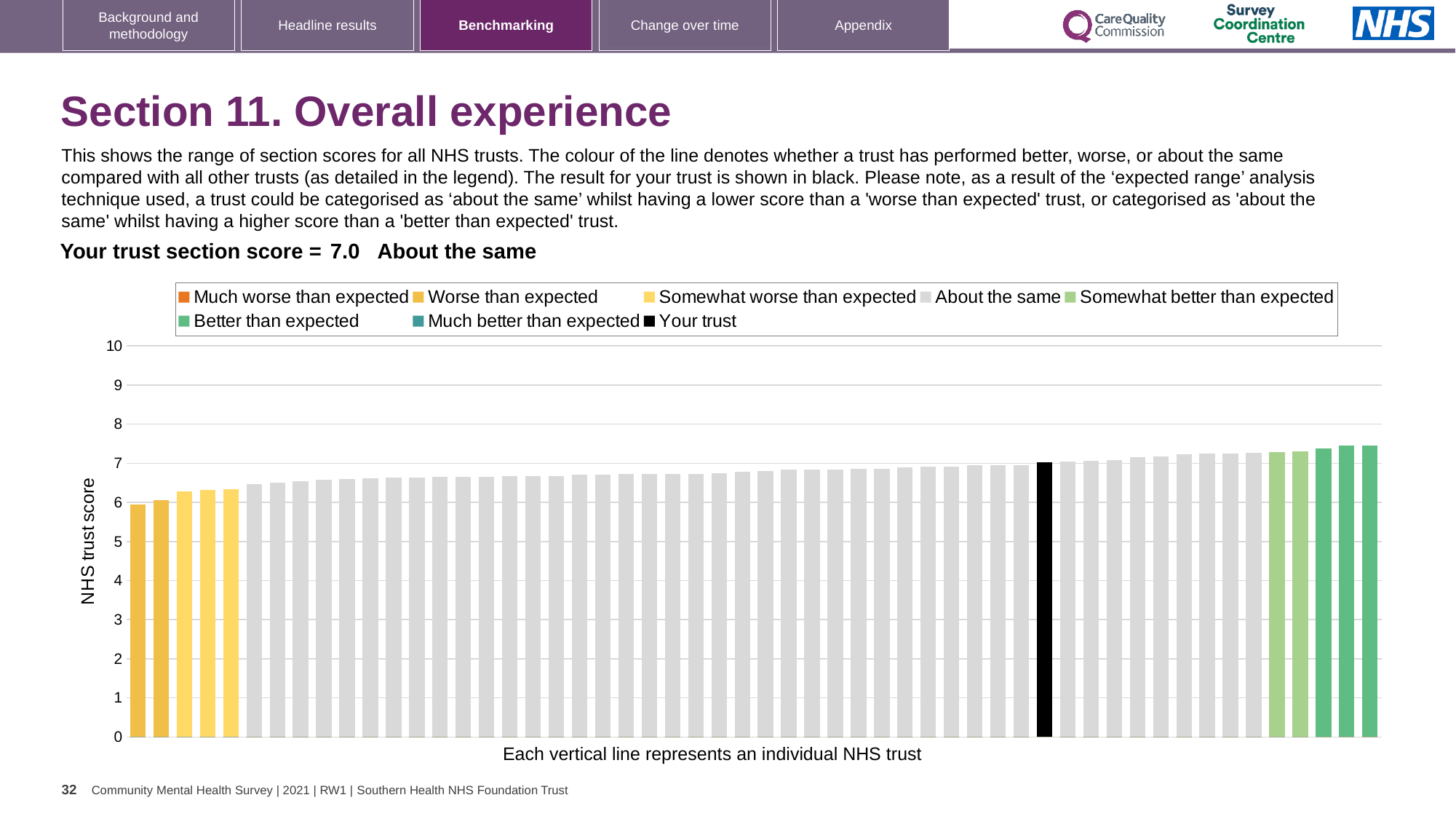
What kind of chart is shown on the slide? Bar chart How many entries does the chart legend list? 8 Is the value of the black 'Your trust' bar greater or less than 6? greater Is the value of the tallest bar on the chart greater or less than 7? greater What colour is used for the 'Your trust' bar in the chart? Black Which is taller, the leftmost bar or the black 'Your trust' bar? The black 'Your trust' bar What is the title of the vertical axis? NHS trust score Is the value of the tallest bar on the chart greater or less than 8? less What is the section score for your trust shown on the slide? 7.0 Which category is your trust placed in for this section? About the same Do the bar values rise or fall moving from left to right along the x axis? rise